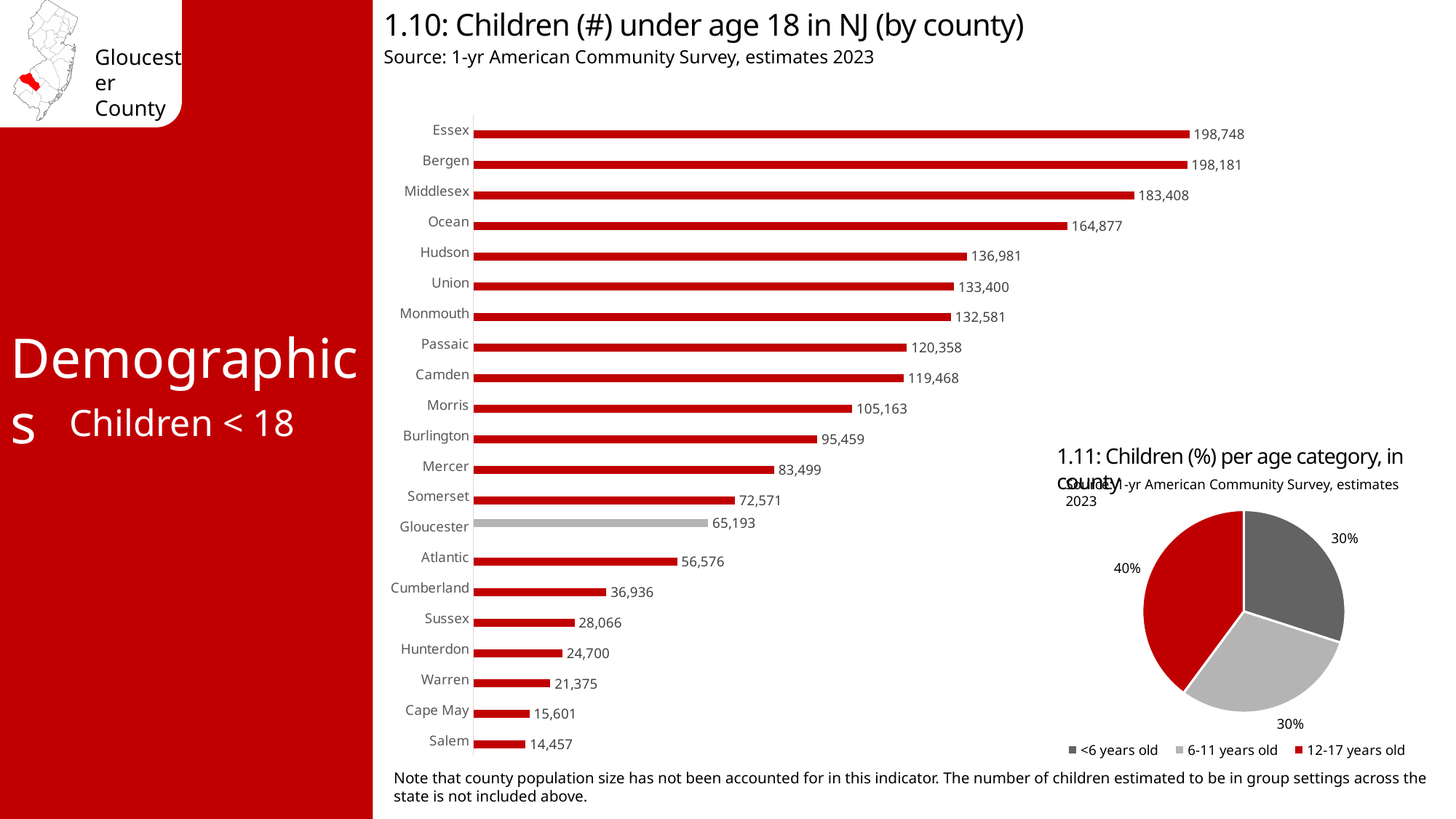
In chart 1.11, what percentage of children are under 6 years old? 30% In chart 1.10, which county has the highest number of children under 18? Essex In chart 1.11, what share of children are 12-17 years old? 40% In chart 1.10, which county has the lowest number of children under 18? Salem In chart 1.10, what is the value for Camden? 119,468 How many counties are shown in chart 1.10? 21 What kind of chart is chart 1.10? Bar chart In chart 1.10, how many children under age 18 are in Gloucester County? 65,193 In chart 1.10, which has more children under 18, Passaic or Morris? Passaic In chart 1.10, which county's bar is coloured grey instead of red? Gloucester In chart 1.10, what is the difference between Somerset and Gloucester? 7,378 How many age categories does the legend of chart 1.11 list? 3